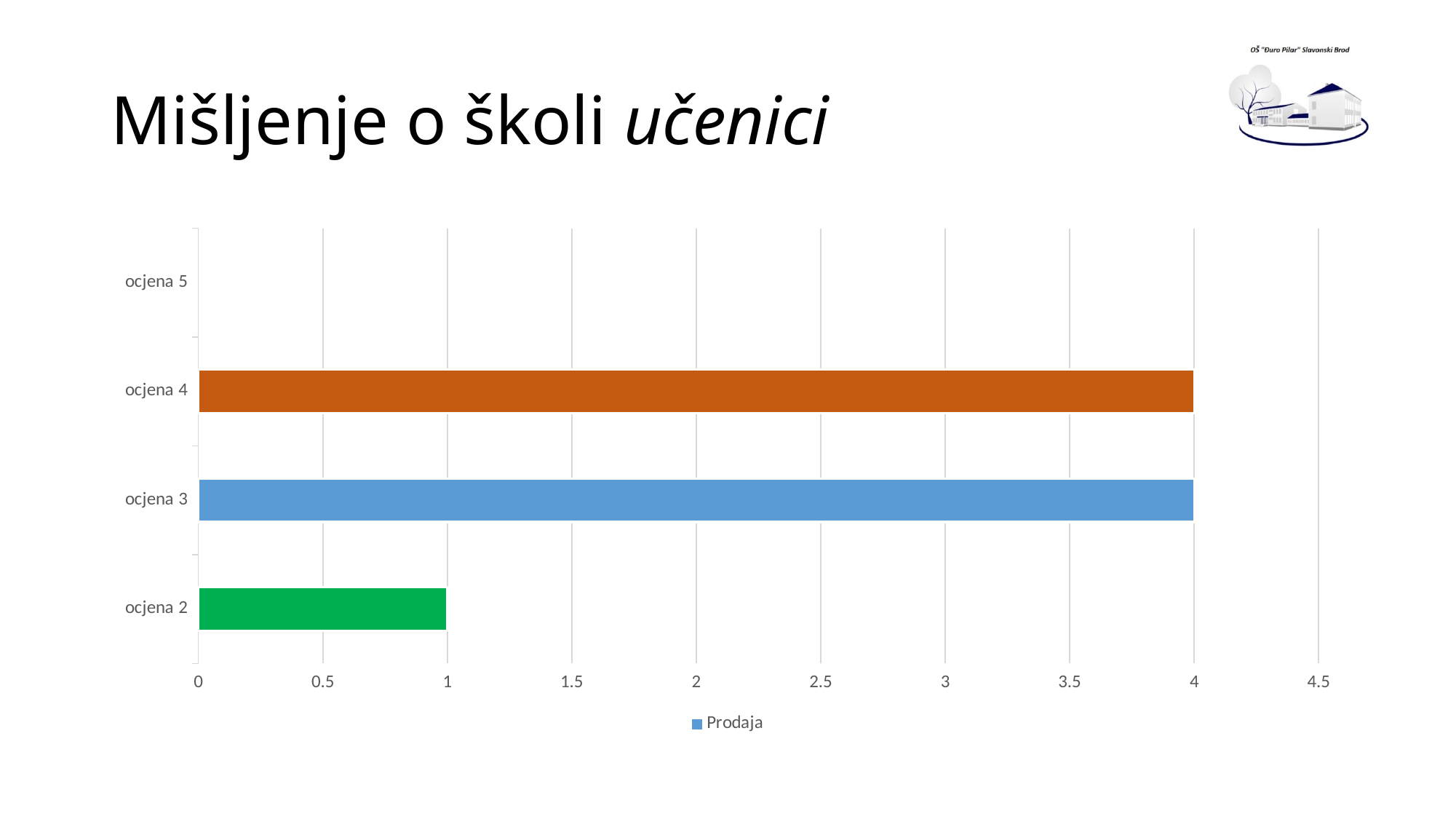
Is the value for ocjena 2 greater or less than 2? less What is the value for ocjena 3? 4 What is the value for ocjena 2? 1 Which category has no visible bar? ocjena 5 What kind of chart is shown on the slide? bar chart How many series does the legend list? 1 Is the value for ocjena 4 greater or less than 3? greater What is the value for ocjena 4? 4 How many categories are shown on the vertical axis? 4 What is the name of the series in the legend? Prodaja Which is larger, the value for ocjena 3 or the value for ocjena 2? ocjena 3 What is the difference between the values for ocjena 4 and ocjena 2? 3